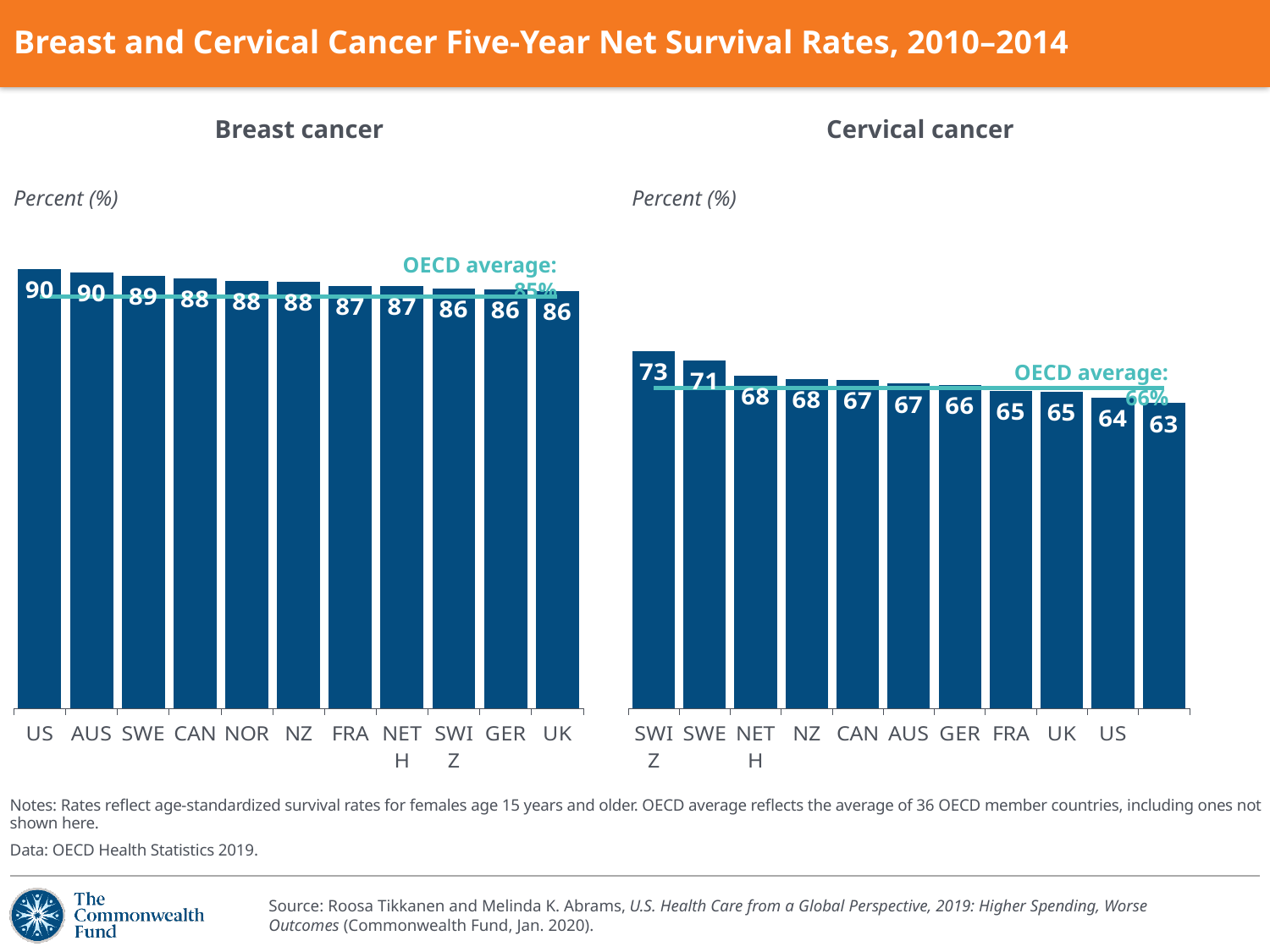
In the Breast cancer chart, how many countries are shown? 11 In the Breast cancer chart, what is the value for the UK? 86 In the Cervical cancer chart, what is the value for the US? 64 In the Cervical cancer chart, what is the difference between the SWIZ value and the US value? 9 What type of chart is the Breast cancer chart? Bar chart In the Breast cancer chart, what is the five-year net survival rate for Sweden (SWE)? 89 In the Cervical cancer chart, what OECD average is shown? 66% In the Cervical cancer chart, which is larger, the value for SWE or the value for GER? SWE In the Breast cancer chart, what OECD average is shown? 85% In the Breast cancer chart, what is the difference between the US value and the UK value? 4 In the Cervical cancer chart, what is the value for Canada (CAN)? 67 In the Cervical cancer chart, which labeled country has the highest survival rate? SWIZ